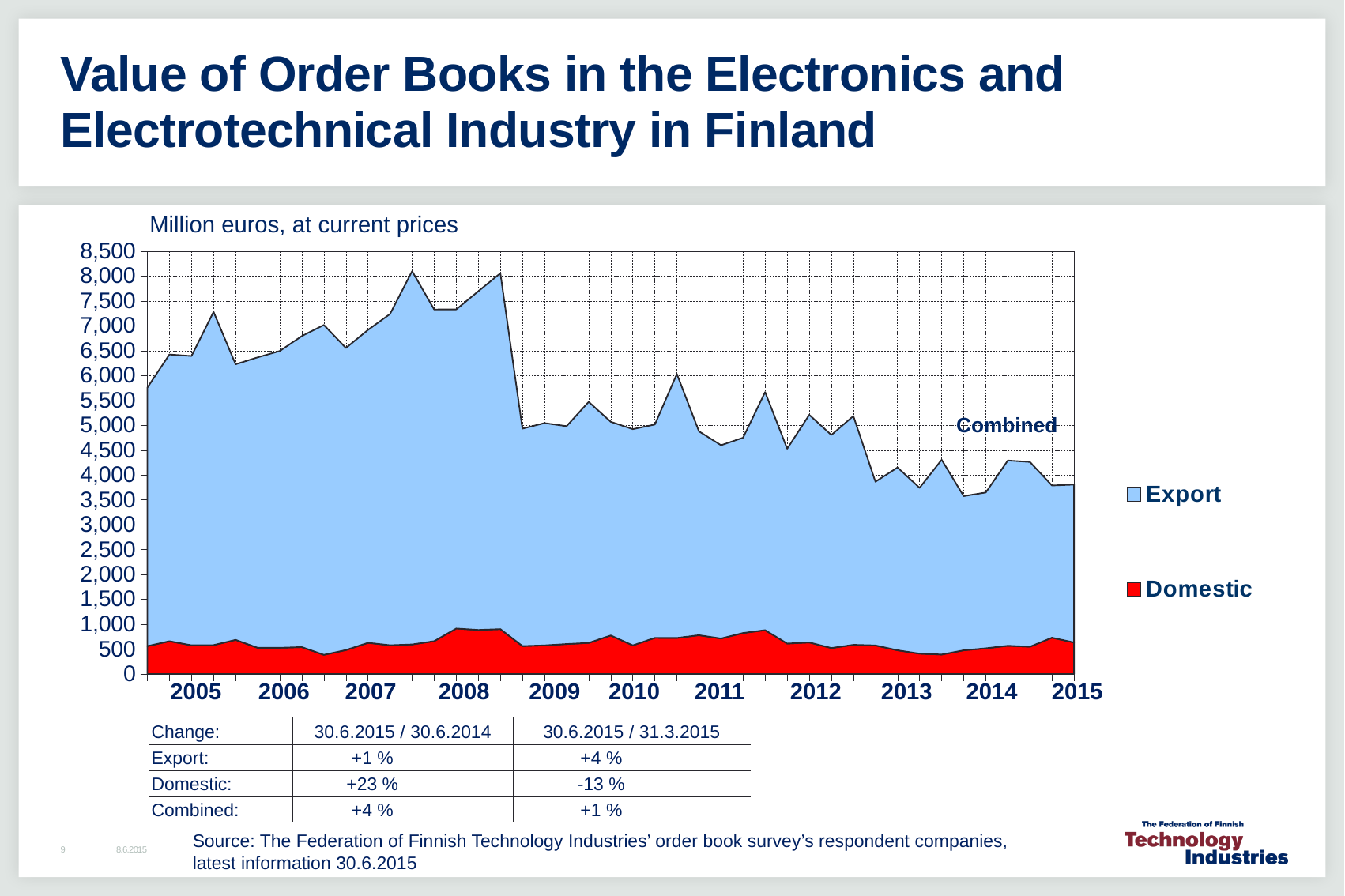
Which is larger, the combined value in 2007 or the combined value in 2013? 2007 Do the combined values generally rise or fall from 2008 to 2015? Fall How many year labels are shown on the chart's x axis? 11 Is the peak combined value in 2008 greater or less than 7,500? greater What are the two series named in the chart's legend? Export and Domestic What unit label is shown above the chart's y axis? Million euros, at current prices Is the combined value at the start of 2005 greater or less than 5,000? greater Do the Domestic values ever exceed 1,000 on the chart? No How many series does the chart's legend list? 2 What kind of chart is shown on the slide? Area chart